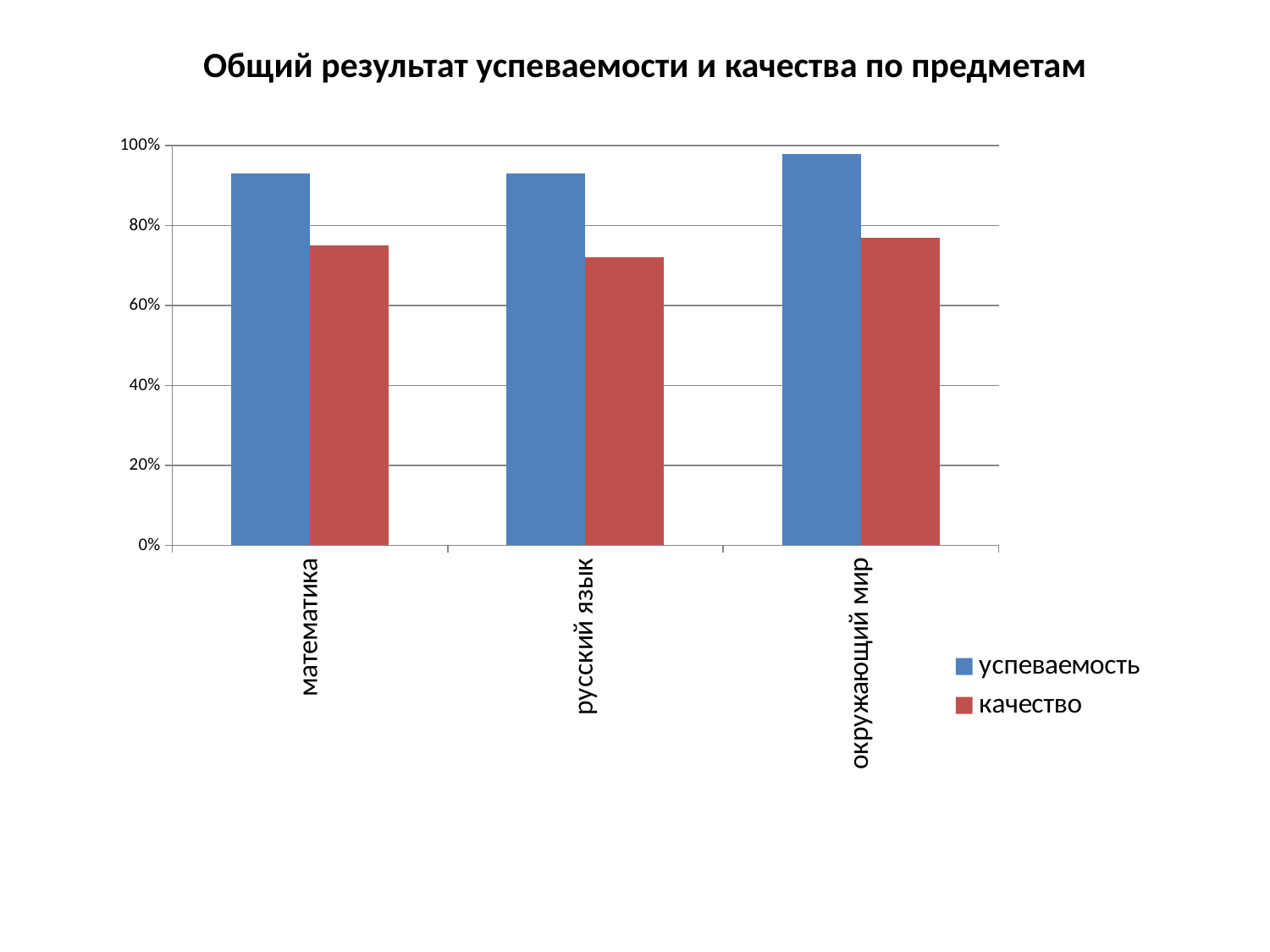
Which series is shown in red? качество For окружающий мир, which is larger: качество or успеваемость? успеваемость How many series does the legend list? 2 Is the успеваемость value for математика greater or less than 80%? greater Is the успеваемость value for окружающий мир greater or less than 80%? greater What kind of chart is shown on the slide? bar chart Is the качество value for русский язык greater or less than 60%? greater For русский язык, which is larger: успеваемость or качество? успеваемость What is the title of the chart? Общий результат успеваемости и качества по предметам How many subjects (categories) are shown on the x axis? 3 Which subject has the highest успеваемость value? окружающий мир